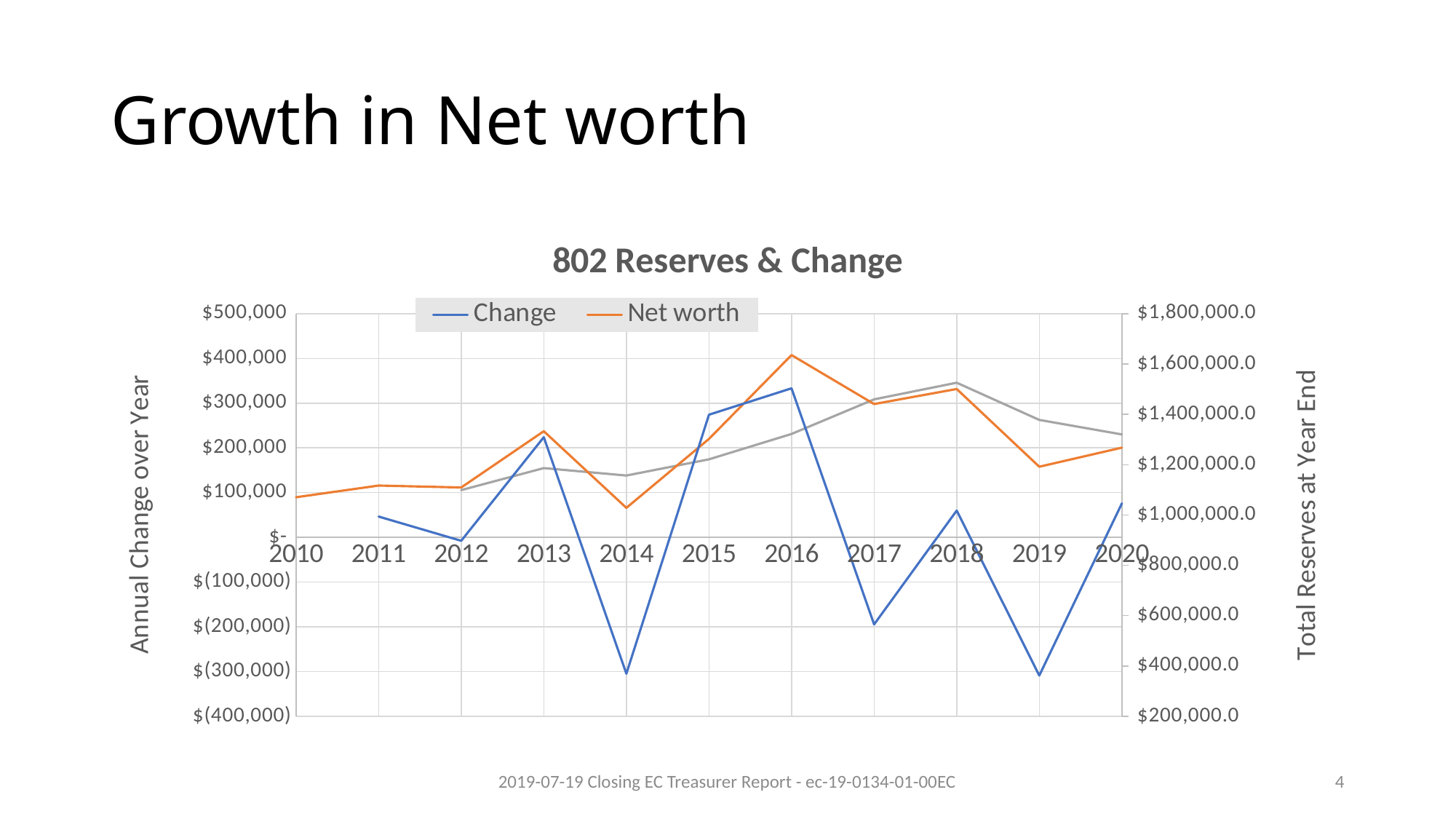
How many series does the chart legend list? 2 Which is larger, the Change value for 2013 or for 2015? 2015 Does the Net worth series rise or fall from 2014 to 2016? rise In which year does the Net worth series reach its highest value? 2016 How many years are shown on the x axis of the chart? 11 Is the value of Change for 2014 greater or less than $(200,000)? less What is the title of the right-hand vertical axis? Total Reserves at Year End Is the value of Net worth for 2019 greater or less than $1,400,000.0? less In which year does the Change series reach its highest value? 2016 Is the value of Change for 2016 greater or less than $300,000? greater What kind of chart is shown on the slide? Line chart What is the title of the chart? 802 Reserves & Change